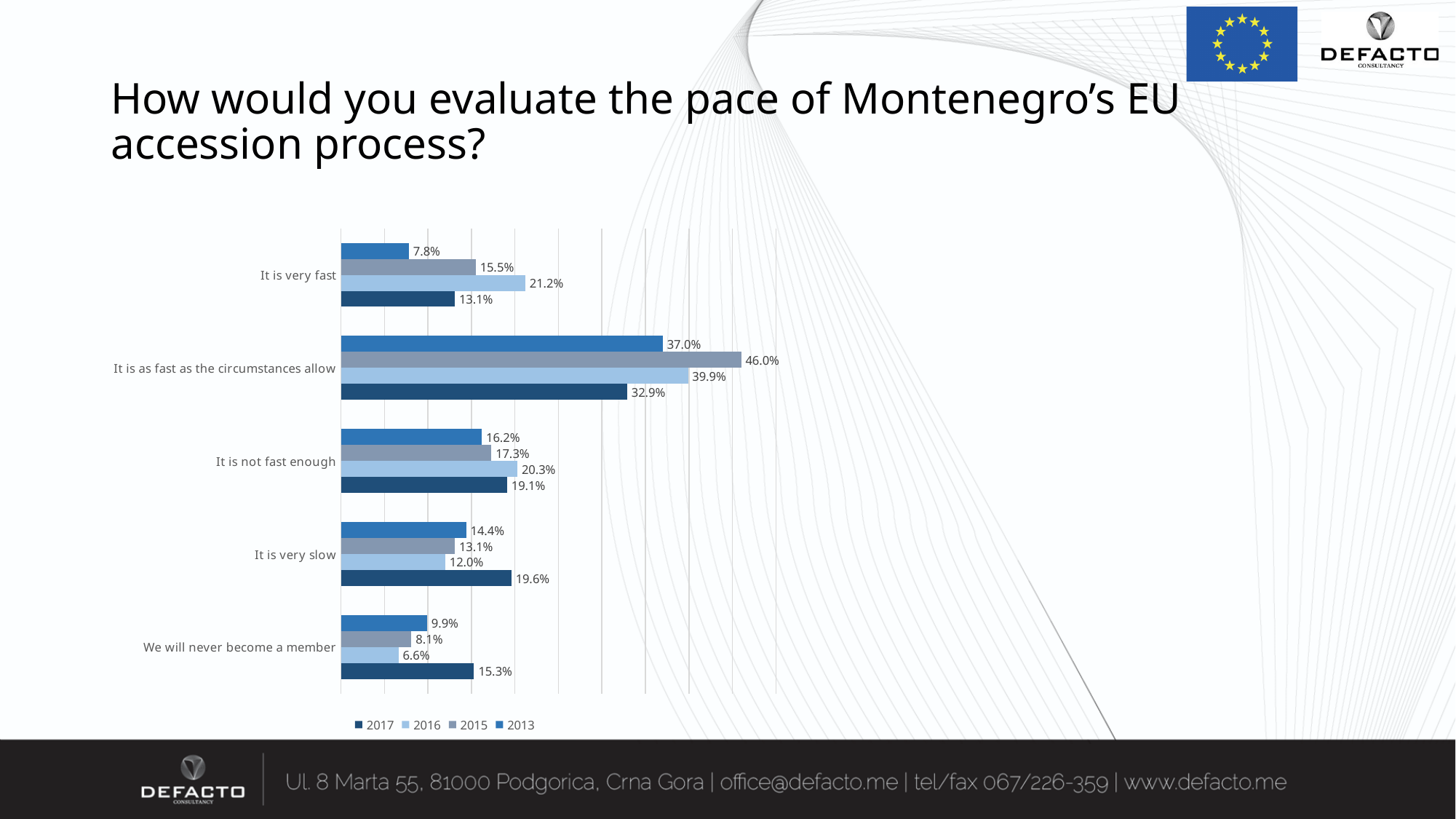
What is the 2013 value for "We will never become a member"? 9.9% What is the 2015 value for "It is very slow"? 13.1% What is the 2016 value for "It is very fast"? 21.2% Which category has the lowest 2016 value? We will never become a member What is the difference between the 2015 and 2017 values for "It is as fast as the circumstances allow"? 13.1% Which is larger for "It is very slow": the 2017 value or the 2016 value? 2017 What type of chart is shown on the slide? Bar chart What is the 2017 value for "It is as fast as the circumstances allow"? 32.9% How many series does the legend list? 4 Which category has the highest 2015 value? It is as fast as the circumstances allow Which years are listed in the chart legend? 2017, 2016, 2015, 2013 How many response categories are shown on the chart? 5